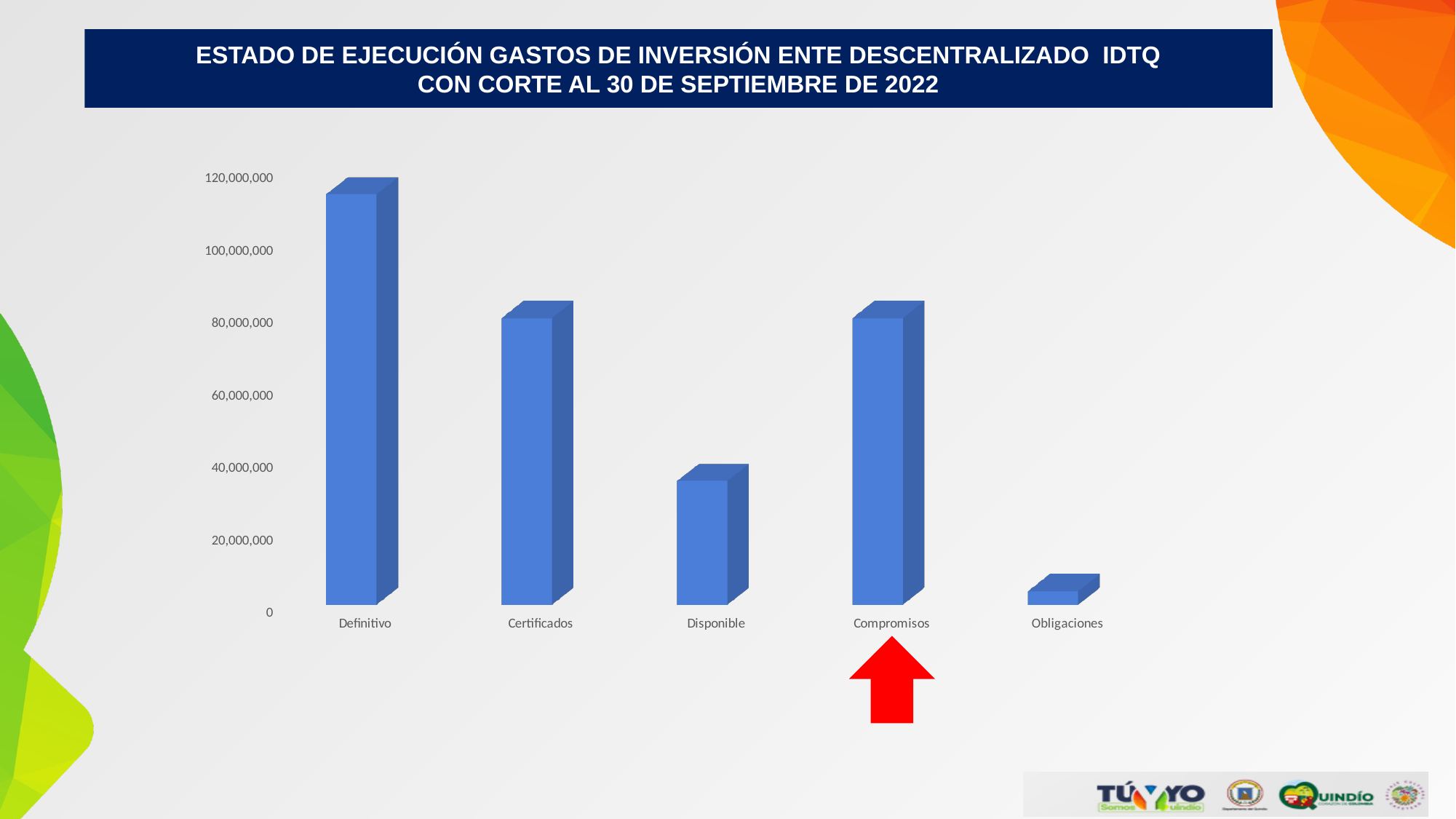
What kind of chart is shown on the slide? bar chart Is the value for Compromisos greater or less than 100,000,000? less Which is larger, the value for Definitivo or the value for Certificados? Definitivo Is the value for Obligaciones greater or less than 20,000,000? less Which category has the lowest bar in the chart? Obligaciones Which category does the red arrow below the chart point to? Compromisos Is the value for Disponible greater or less than 40,000,000? less How many categories are shown on the x axis of the chart? 5 Which category has the highest bar in the chart? Definitivo Which is larger, the value for Disponible or the value for Obligaciones? Disponible